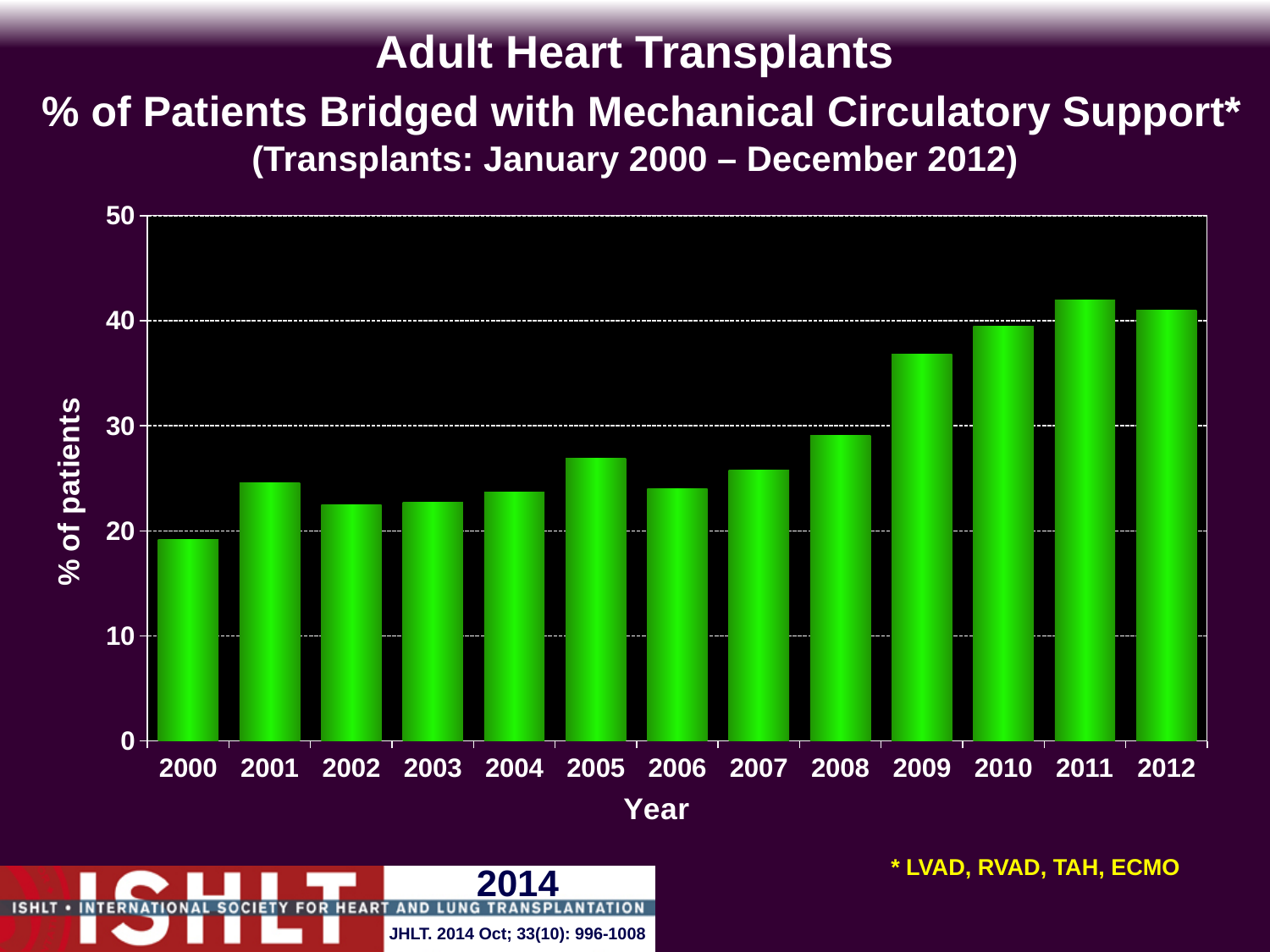
Is the value for 2008 greater or less than 30? less What kind of chart is shown on the slide? bar chart Which year has the highest percentage of patients bridged with mechanical circulatory support? 2011 What is the label on the y axis of the chart? % of patients Which year has the lowest percentage of patients bridged with mechanical circulatory support? 2000 Overall, do the values rise or fall from 2000 to 2012? rise Is the value for 2009 greater or less than 30? greater Is the value for 2011 greater or less than 40? greater Which year has a higher value, 2005 or 2006? 2005 Which year has a higher value, 2008 or 2009? 2009 How many years are shown on the x axis of the chart? 13